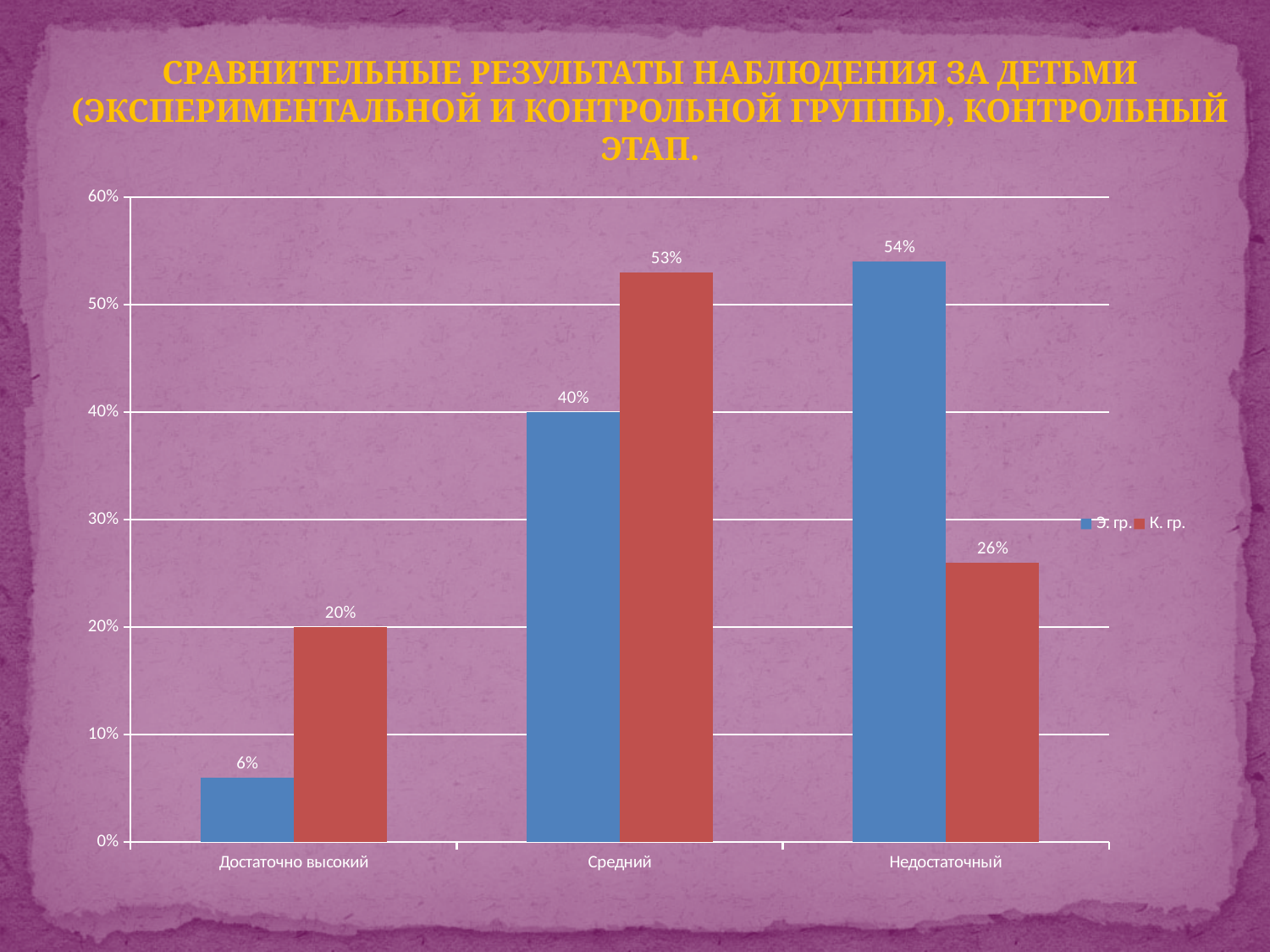
What is the value for К. гр. in the Средний category? 53% What is the value for К. гр. in the Достаточно высокий category? 20% Which category has the lowest value for the К. гр. series? Достаточно высокий What is the value for Э. гр. in the Достаточно высокий category? 6% Which colour represents the К. гр. series? Red How many categories are shown on the x axis? 3 What is the difference between the К. гр. and Э. гр. values in the Средний category? 13% What kind of chart is shown on the slide? Bar chart How many series does the legend list? 2 Which category has the highest value for the Э. гр. series? Недостаточный In the Недостаточный category, which series has the larger value, Э. гр. or К. гр.? Э. гр. What is the value for Э. гр. in the Недостаточный category? 54%